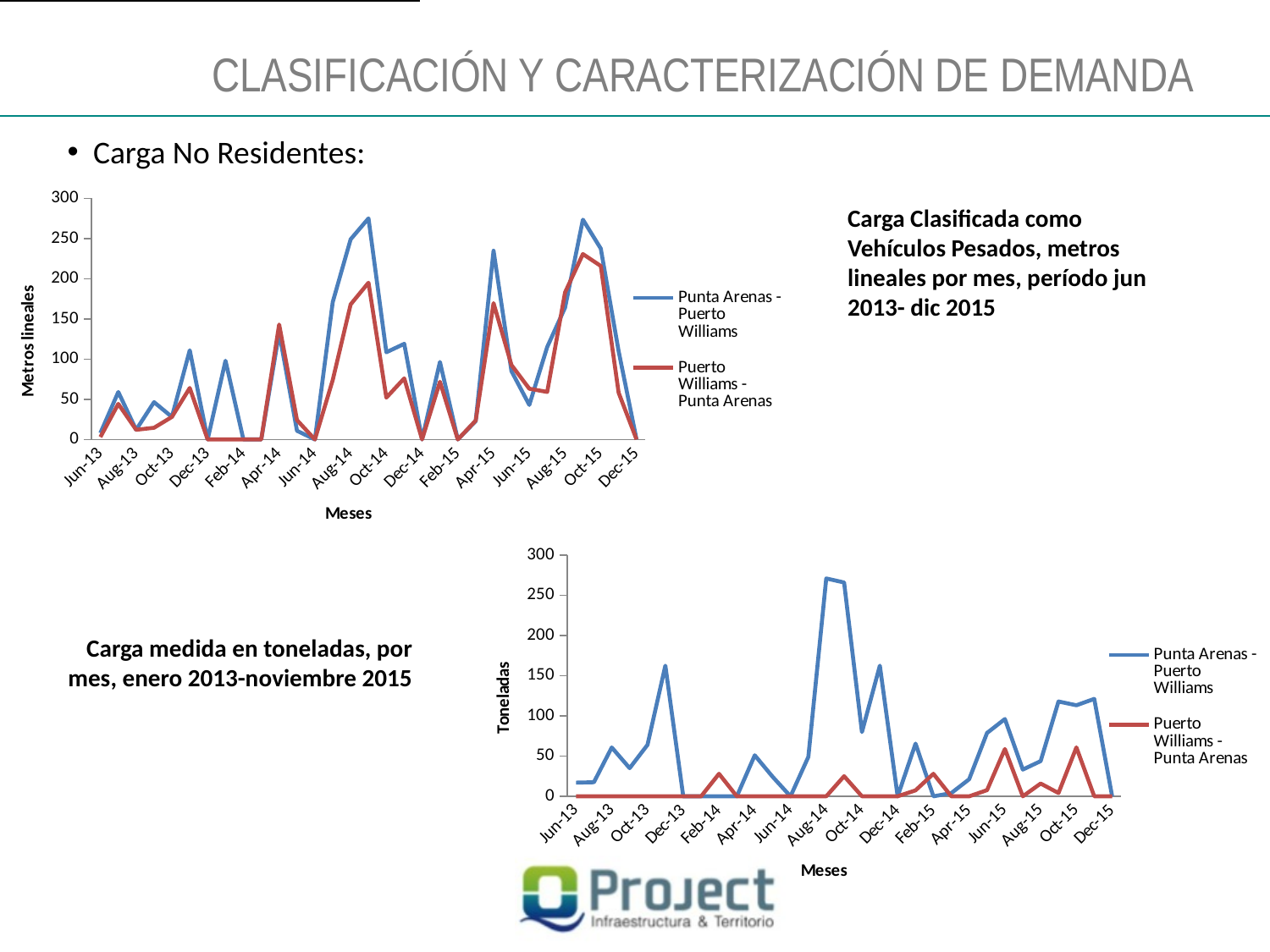
What kind of chart is the top chart (Metros lineales)? Line chart In the top chart (Metros lineales), which series is higher around Sep-14, Punta Arenas - Puerto Williams or Puerto Williams - Punta Arenas? Punta Arenas - Puerto Williams In the bottom chart (Toneladas), is the value for Puerto Williams - Punta Arenas at Aug-14 greater or less than 50? less How many series does the legend of the top chart (Metros lineales) list? 2 In the top chart (Metros lineales), is the value for Puerto Williams - Punta Arenas at Oct-15 greater or less than 200? greater In the bottom chart (Toneladas), which series reaches the highest peak? Punta Arenas - Puerto Williams What is the y-axis title of the bottom chart? Toneladas In the bottom chart (Toneladas), is the value for Punta Arenas - Puerto Williams at Aug-14 greater or less than 250? greater What is the x-axis title of the top chart (Metros lineales)? Meses How many series does the legend of the bottom chart (Toneladas) list? 2 What kind of chart is the bottom chart (Toneladas)? Line chart